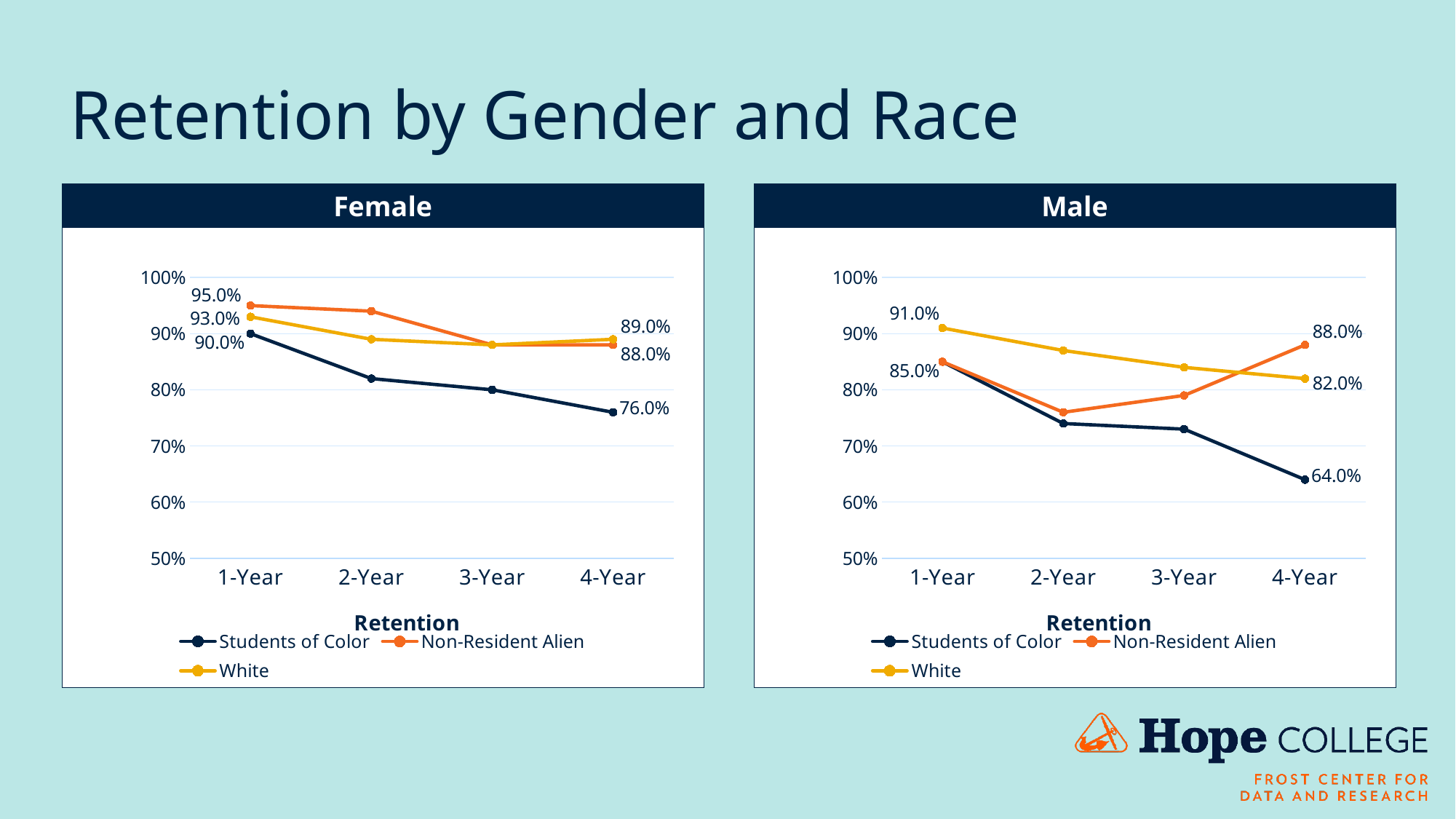
In the Female chart, what is the 4-Year retention value for Students of Color? 76.0% How many series does the legend of the Female chart list? 3 In the Male chart, which series has the highest retention at 4-Year? Non-Resident Alien In the Female chart, which series has the lowest retention at 4-Year? Students of Color In the Male chart, what is the 1-Year retention value for White students? 91.0% In the Female chart, what is the 1-Year retention value for Non-Resident Alien students? 95.0% In the Male chart, what is the difference between the 4-Year retention of Non-Resident Alien students and Students of Color? 24.0 percentage points In the Female chart, by how many percentage points does White retention drop from 1-Year to 4-Year? 4.0 percentage points In the Male chart, is the 2-Year retention value for Non-Resident Alien students greater or less than 80%? less In the Male chart, what is the 4-Year retention value for Students of Color? 64.0% In the Female chart, is the 2-Year retention value for Students of Color greater or less than 90%? less In the Male chart, what is the 4-Year retention value for Non-Resident Alien students? 88.0%